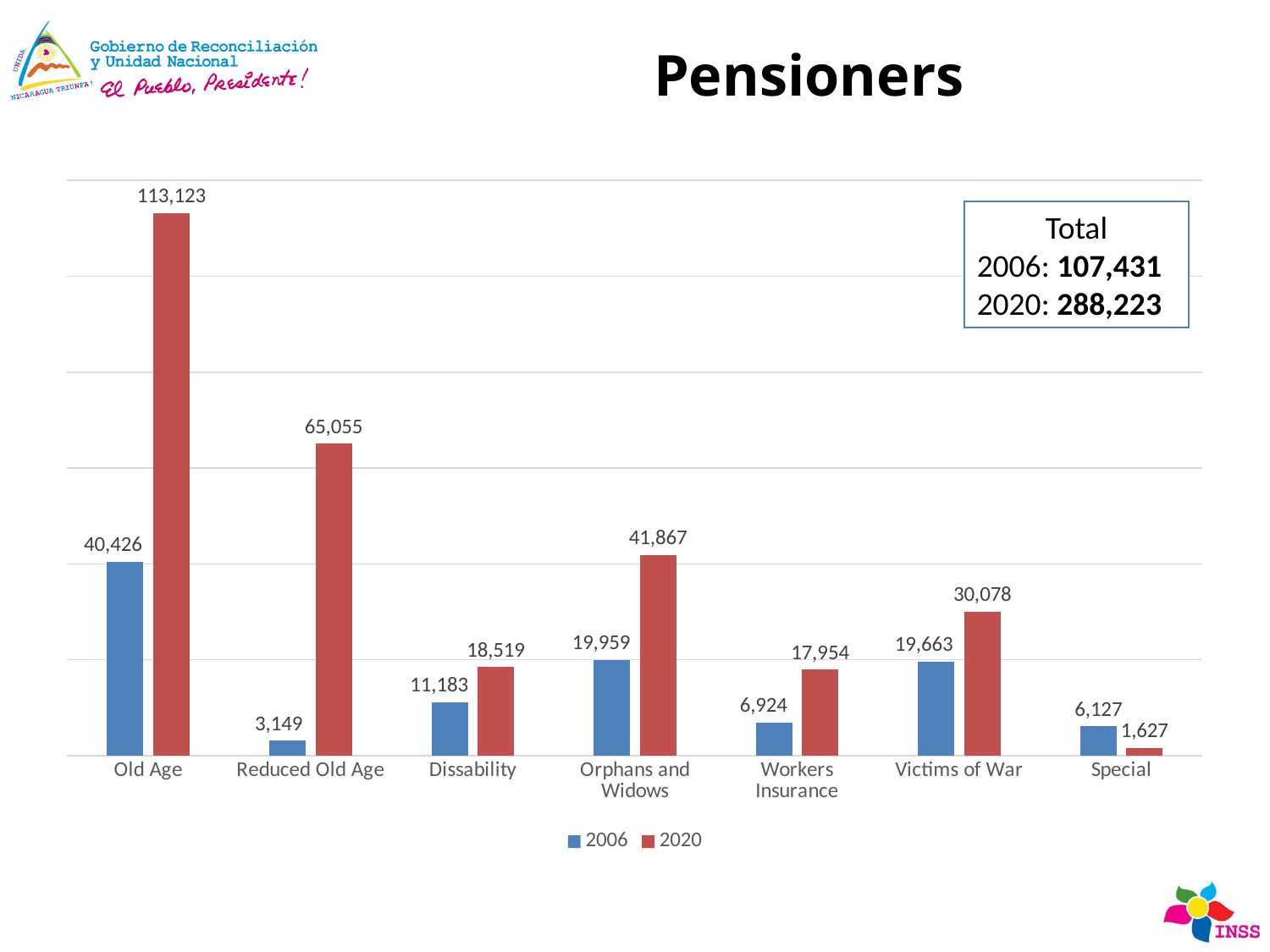
How many series does the legend list? 2 How many categories are shown on the x axis? 7 What is the difference between the 2020 and 2006 values for Victims of War? 10,415 What is the difference between the 2020 and 2006 values for Old Age? 72,697 What is the value for Old Age in 2020? 113,123 For Special, which year has the larger value, 2006 or 2020? 2006 What kind of chart is shown on the slide? Bar chart What is the value for Reduced Old Age in 2006? 3,149 Which category has the lowest value in 2006? Reduced Old Age What is the value for Special in 2020? 1,627 Which category has the highest value in 2020? Old Age What is the value for Workers Insurance in 2020? 17,954